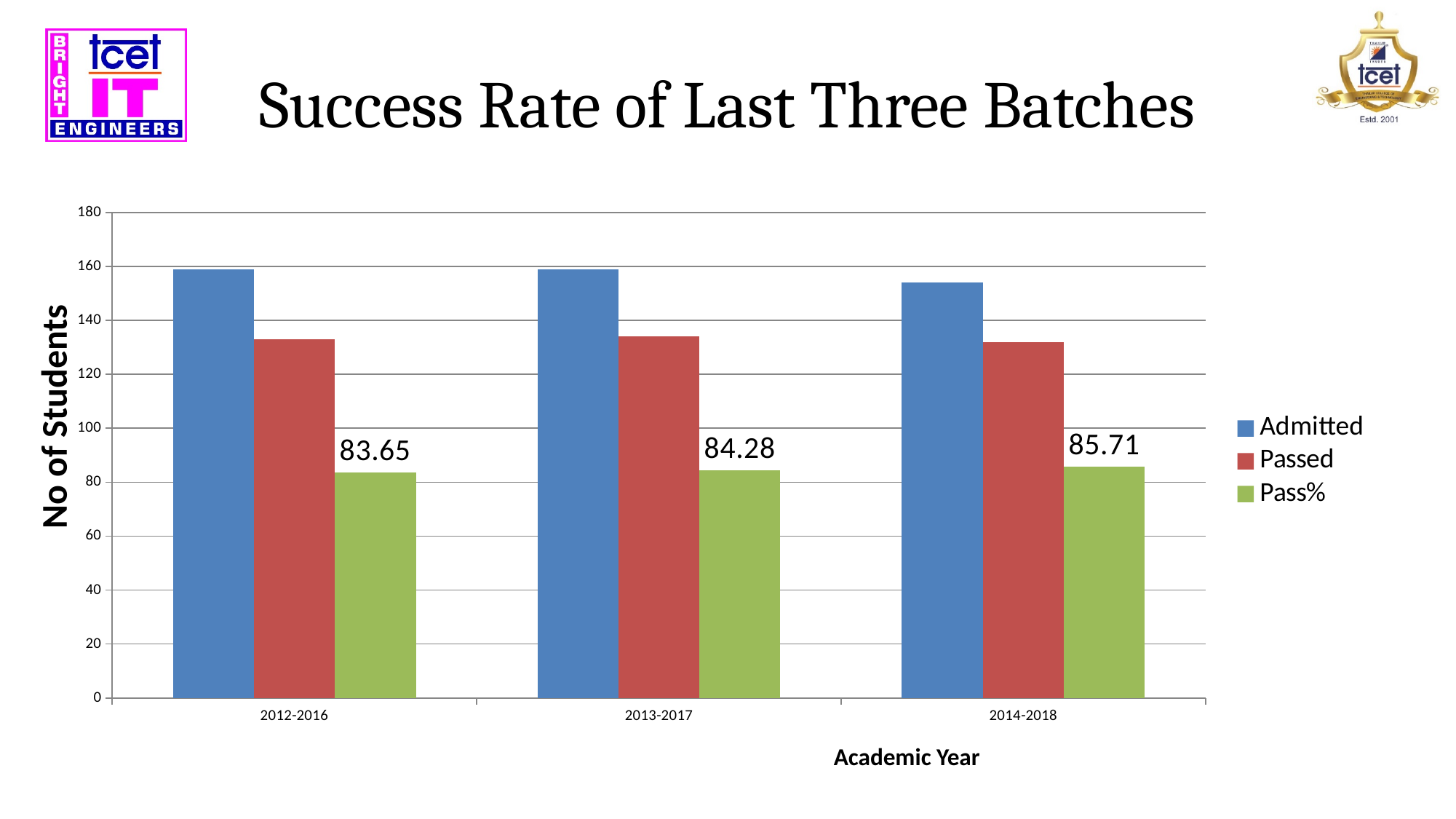
What is the difference between the Pass% for 2014-2018 and the Pass% for 2012-2016? 2.06 Which academic year has the highest Pass%? 2014-2018 Is the Admitted value for 2012-2016 greater or less than 140? greater Which academic year has the lowest Pass%? 2012-2016 How many academic year categories are shown on the x axis? 3 What is the Pass% value for the 2012-2016 batch? 83.65 Does the Pass% rise or fall from 2012-2016 to 2014-2018? rise What is the Pass% value for the 2013-2017 batch? 84.28 How many series does the legend list? 3 What is the Pass% value for the 2014-2018 batch? 85.71 Is the Passed value for 2014-2018 greater or less than 140? less For the 2013-2017 batch, which is larger: the Admitted bar or the Passed bar? Admitted